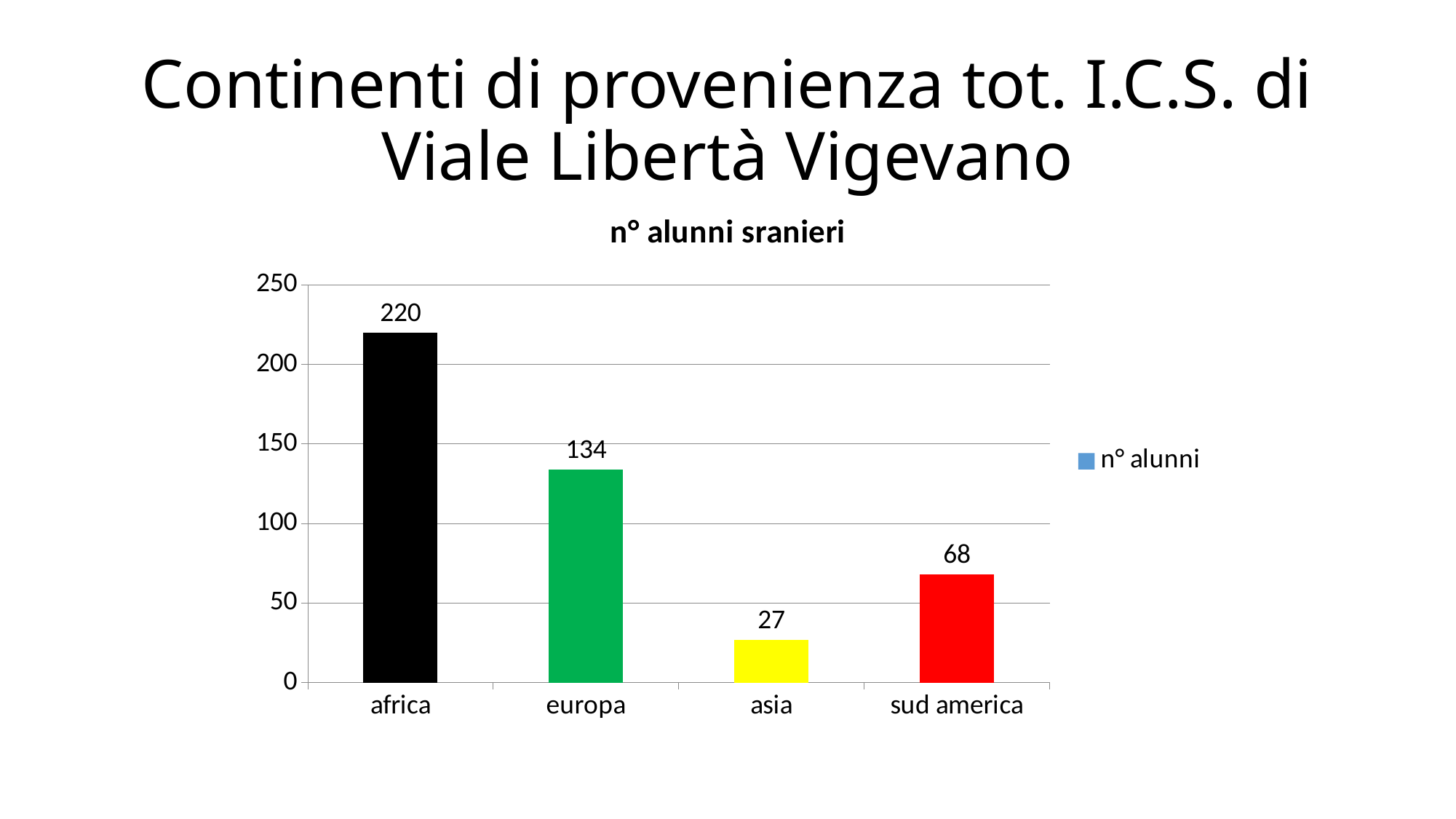
What is the value for africa? 220 What kind of chart is shown on the slide? bar chart Which is larger, the value for sud america or the value for asia? sud america How many series does the legend list? 1 What is the title of the chart? n° alunni sranieri What is the difference between the values for africa and europa? 86 Which continent has the highest number of pupils? africa What is the value for asia? 27 What is the value for sud america? 68 What is the value for europa? 134 Which continent has the lowest number of pupils? asia How many continents are shown on the x axis? 4